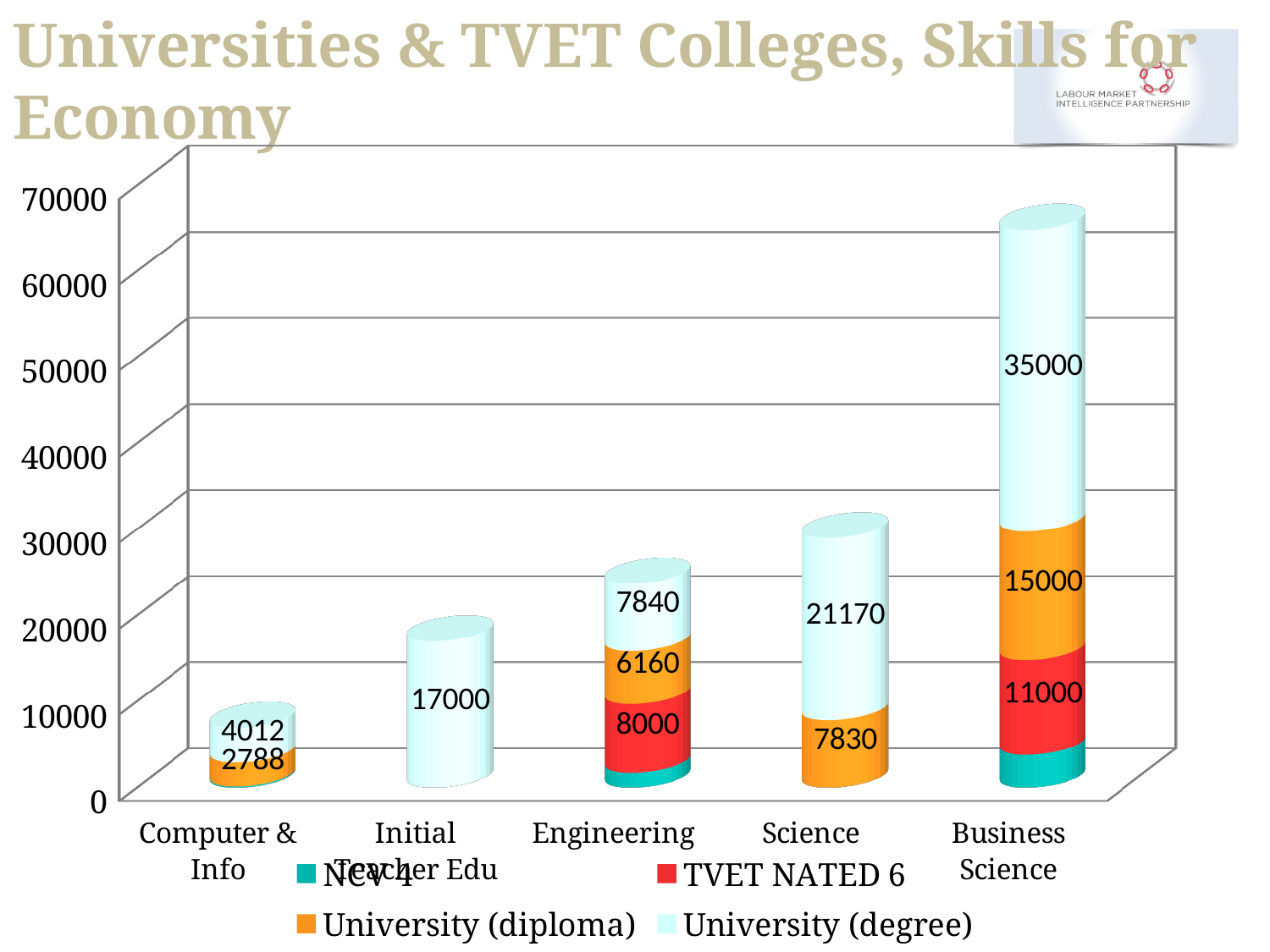
What is the value of University (degree) for Initial Teacher Edu? 17000 What is the total of the Science bar? 29000 Which is larger: the University (degree) value for Science or for Initial Teacher Edu? Science What is the value of University (diploma) for Science? 7830 What is the value of University (degree) for Business Science? 35000 How many series does the legend list? 4 How many categories are shown on the x axis? 5 Which category has the highest University (degree) value? Business Science Which category has the lowest University (degree) value? Computer & Info What is the difference between the University (diploma) values for Business Science and Engineering? 8840 Is the total of the Business Science bar greater or less than 60000? greater What is the value of TVET NATED 6 for Engineering? 8000